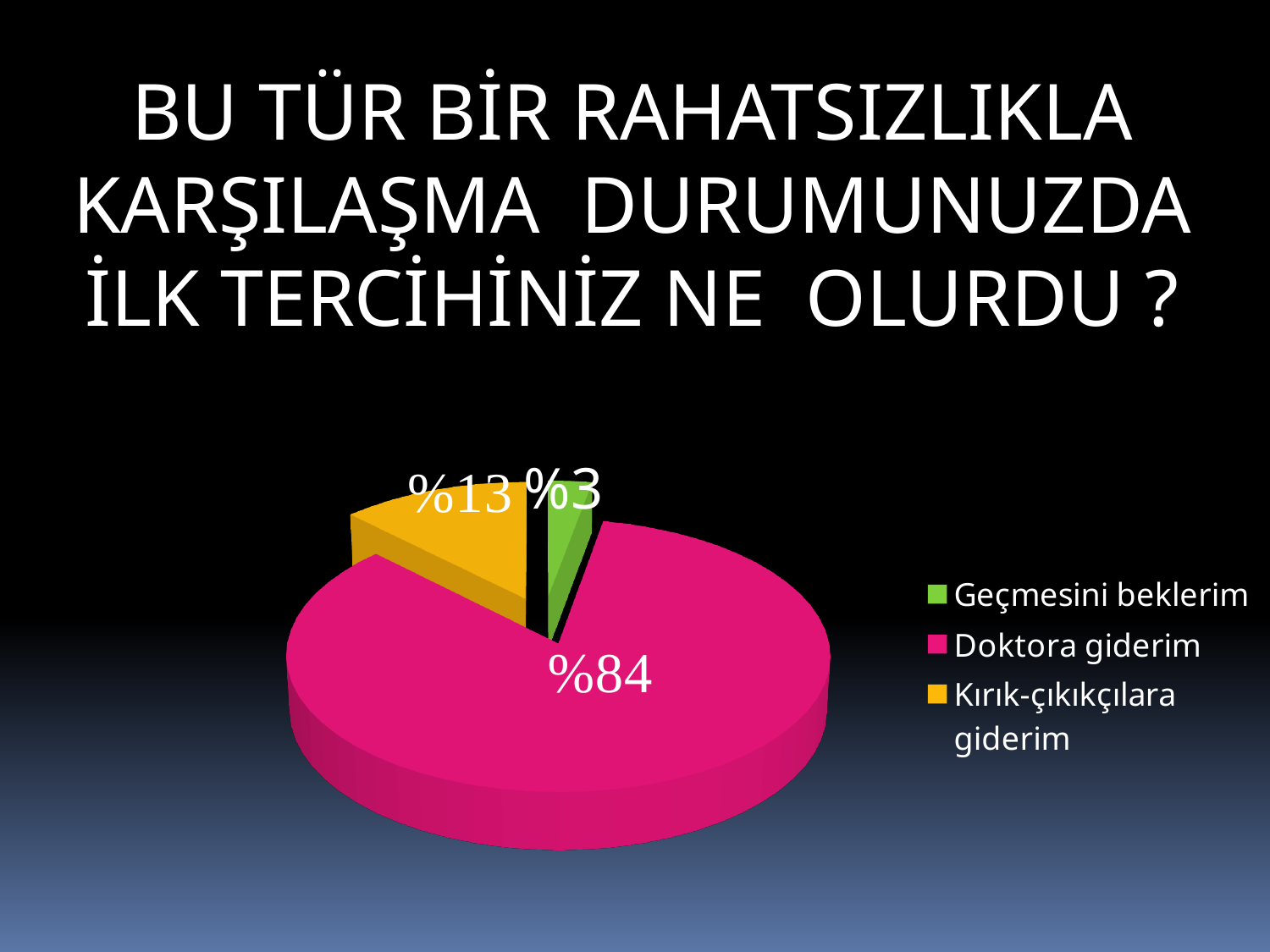
What kind of chart is shown on the slide? pie chart What share of the pie does "Kırık-çıkıkçılara giderim" have? %13 Which is larger, the share for "Kırık-çıkıkçılara giderim" or for "Geçmesini beklerim"? Kırık-çıkıkçılara giderim What share of the pie does "Doktora giderim" have? %84 Which category has the largest slice of the pie? Doktora giderim What colour is the slice for "Doktora giderim"? pink What is the difference between the shares for "Doktora giderim" and "Kırık-çıkıkçılara giderim"? 71 percentage points What share of the pie does "Geçmesini beklerim" have? %3 Which category has the smallest slice of the pie? Geçmesini beklerim What colour is the slice for "Kırık-çıkıkçılara giderim"? yellow How many categories does the pie chart show? 3